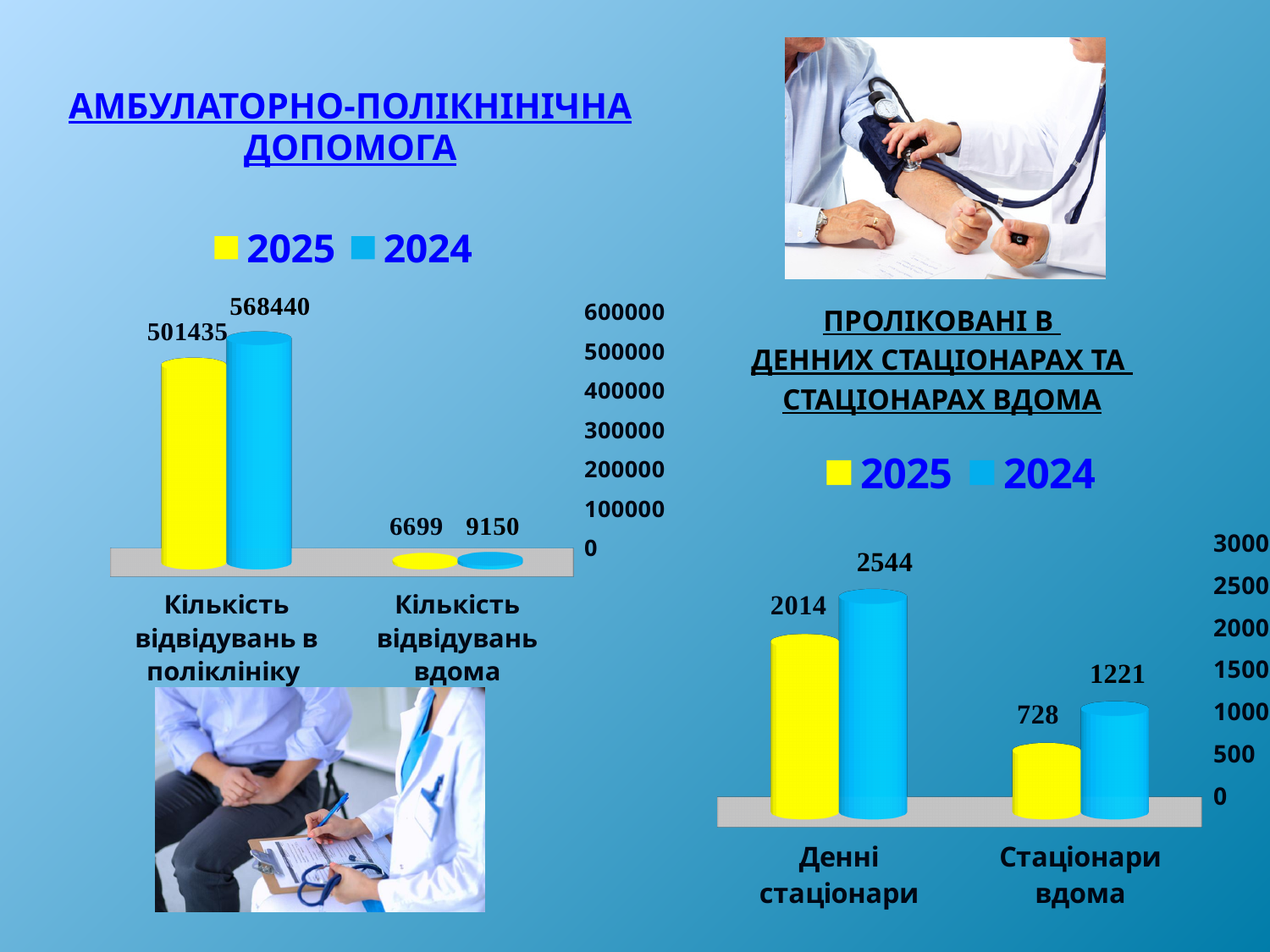
In the left chart (АМБУЛАТОРНО-ПОЛІКНІНІЧНА ДОПОМОГА), what is the 2025 value for Кількість відвідувань в поліклініку? 501435 In the left chart (АМБУЛАТОРНО-ПОЛІКНІНІЧНА ДОПОМОГА), which is larger for Кількість відвідувань вдома: 2025 or 2024? 2024 In the left chart (АМБУЛАТОРНО-ПОЛІКНІНІЧНА ДОПОМОГА), what colour represents 2025? Yellow In the right chart (ПРОЛІКОВАНІ В ДЕННИХ СТАЦІОНАРАХ ТА СТАЦІОНАРАХ ВДОМА), what is the 2024 value for Стаціонари вдома? 1221 In the left chart (АМБУЛАТОРНО-ПОЛІКНІНІЧНА ДОПОМОГА), what is the difference between the 2024 and 2025 values for Кількість відвідувань в поліклініку? 67005 In the right chart (ПРОЛІКОВАНІ В ДЕННИХ СТАЦІОНАРАХ ТА СТАЦІОНАРАХ ВДОМА), how many categories are shown on the x axis? 2 In the left chart (АМБУЛАТОРНО-ПОЛІКНІНІЧНА ДОПОМОГА), what is the 2024 value for Кількість відвідувань вдома? 9150 In the right chart (ПРОЛІКОВАНІ В ДЕННИХ СТАЦІОНАРАХ ТА СТАЦІОНАРАХ ВДОМА), what is the difference between the 2024 and 2025 values for Стаціонари вдома? 493 In the right chart (ПРОЛІКОВАНІ В ДЕННИХ СТАЦІОНАРАХ ТА СТАЦІОНАРАХ ВДОМА), which bar is the highest? Денні стаціонари, 2024 What kind of chart is the right chart (ПРОЛІКОВАНІ В ДЕННИХ СТАЦІОНАРАХ ТА СТАЦІОНАРАХ ВДОМА)? Bar chart In the right chart (ПРОЛІКОВАНІ В ДЕННИХ СТАЦІОНАРАХ ТА СТАЦІОНАРАХ ВДОМА), what is the 2025 value for Денні стаціонари? 2014 In the left chart (АМБУЛАТОРНО-ПОЛІКНІНІЧНА ДОПОМОГА), how many series does the legend list? 2